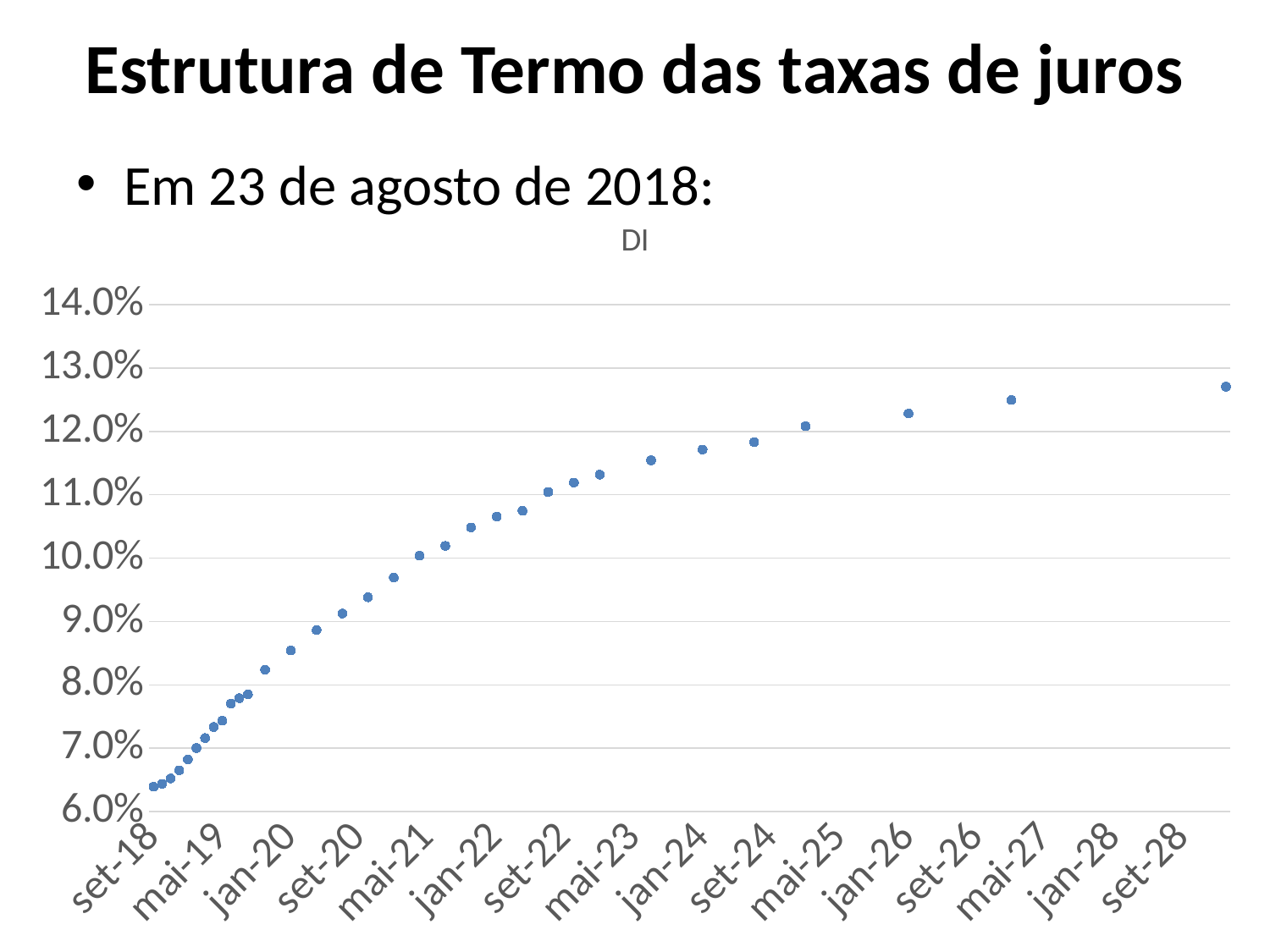
Do the values rise or fall as the dates move from set-18 to set-28? rise Is the value for jan-26 greater or less than 12.0%? greater Is the value for jan-24 greater or less than 12.0%? less What is the highest value shown on the vertical axis of the chart? 14.0% What is the title of the chart? DI Is the value for jan-20 greater or less than 8.0%? greater What kind of chart is shown on the slide? scatter chart